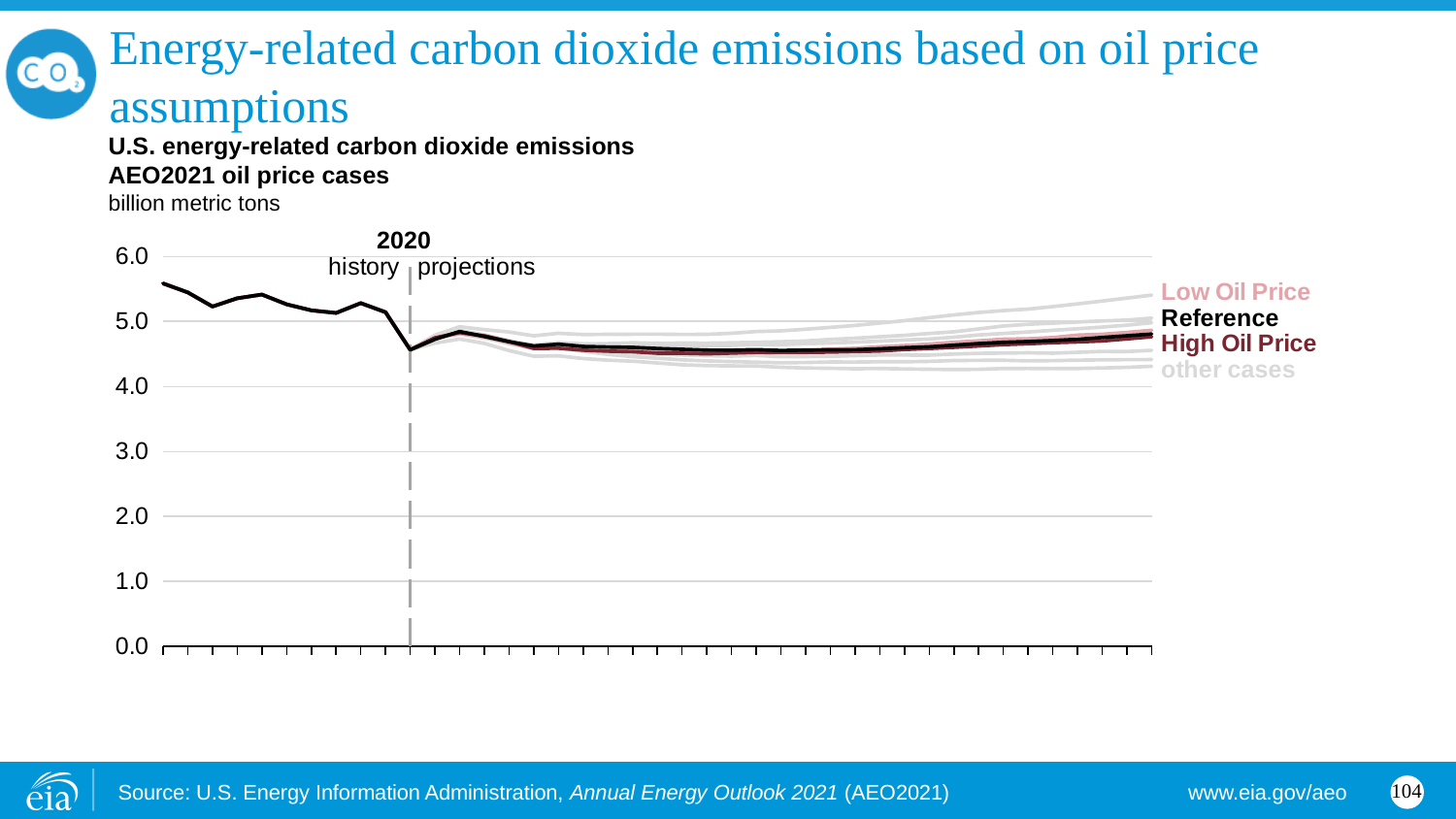
Is the value for the Low Oil Price case at the end of the projection period greater or less than 5.0? less Which named oil price case has the highest emissions at the end of the projection period? Low Oil Price Is the value at the start of the history period greater or less than 5.0? greater What is the highest value shown on the y axis? 6.0 Of the three named oil price cases, which has the lowest emissions at the end of the projection period? High Oil Price What unit is used for the y axis of the chart? billion metric tons What kind of chart is shown on the slide? line chart At the end of the projection period, is the Low Oil Price case higher or lower than the High Oil Price case? higher Is the value for the Reference case at the end of the projection period greater or less than 4.0? greater Do emissions rise or fall over the history portion of the chart, up to 2020? fall Which year does the dashed vertical line separating history from projections mark? 2020